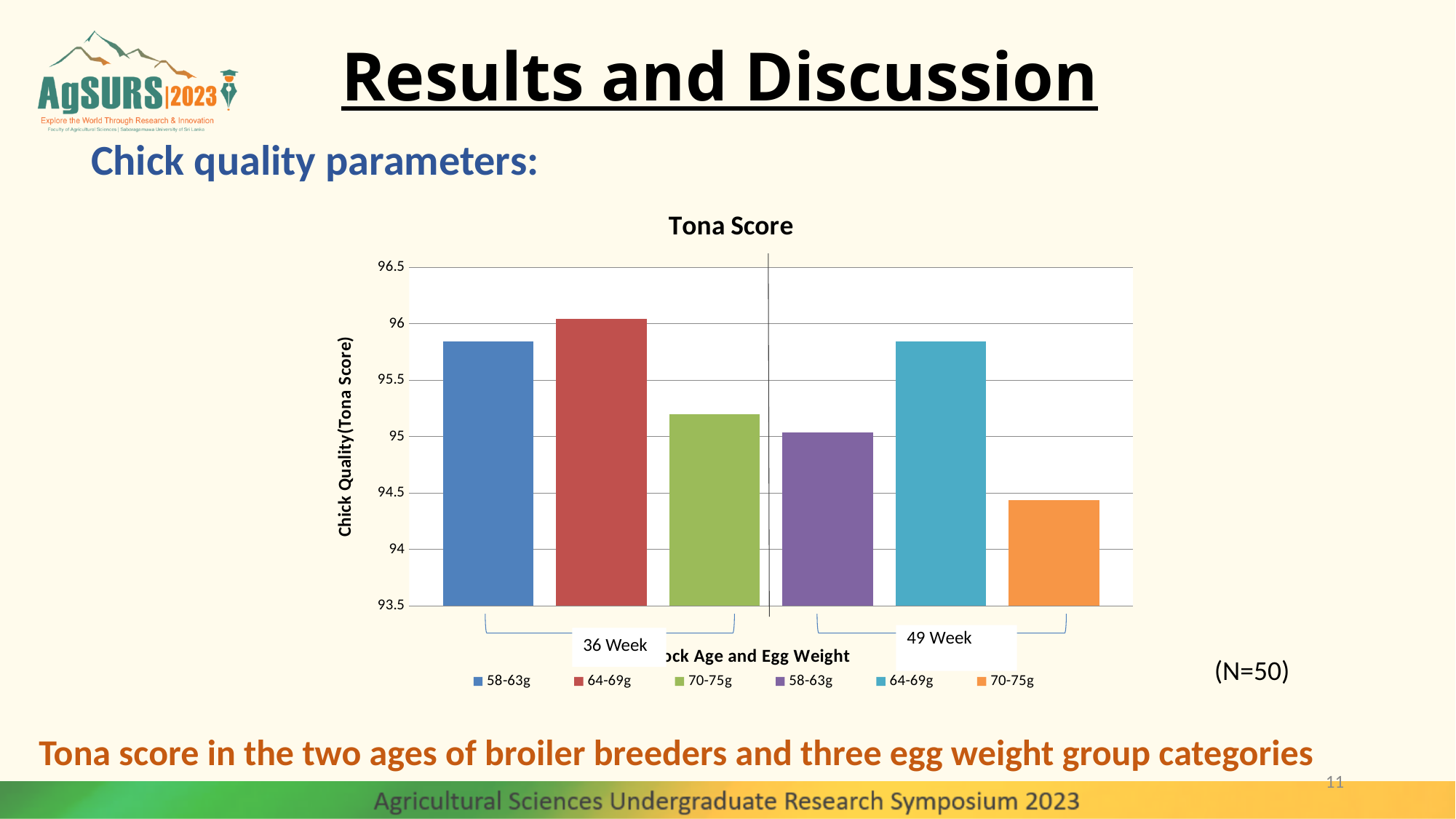
What is the label of the vertical axis? Chick Quality(Tona Score) Is the Tona score for 58-63g at 49 Week greater or less than 94.5? greater How many bars are plotted in the chart? 6 How many entries does the chart legend list? 6 Is the Tona score for 70-75g at 49 Week greater or less than 95? less Is the Tona score for 64-69g at 49 Week greater or less than 95.5? greater What kind of chart is shown on the slide? bar chart What is the title of the chart? Tona Score Which bar has the lowest Tona score? 70-75g at 49 Week Which is larger, the Tona score for 70-75g at 36 Week or for 70-75g at 49 Week? 70-75g at 36 Week Which bar has the highest Tona score? 64-69g at 36 Week